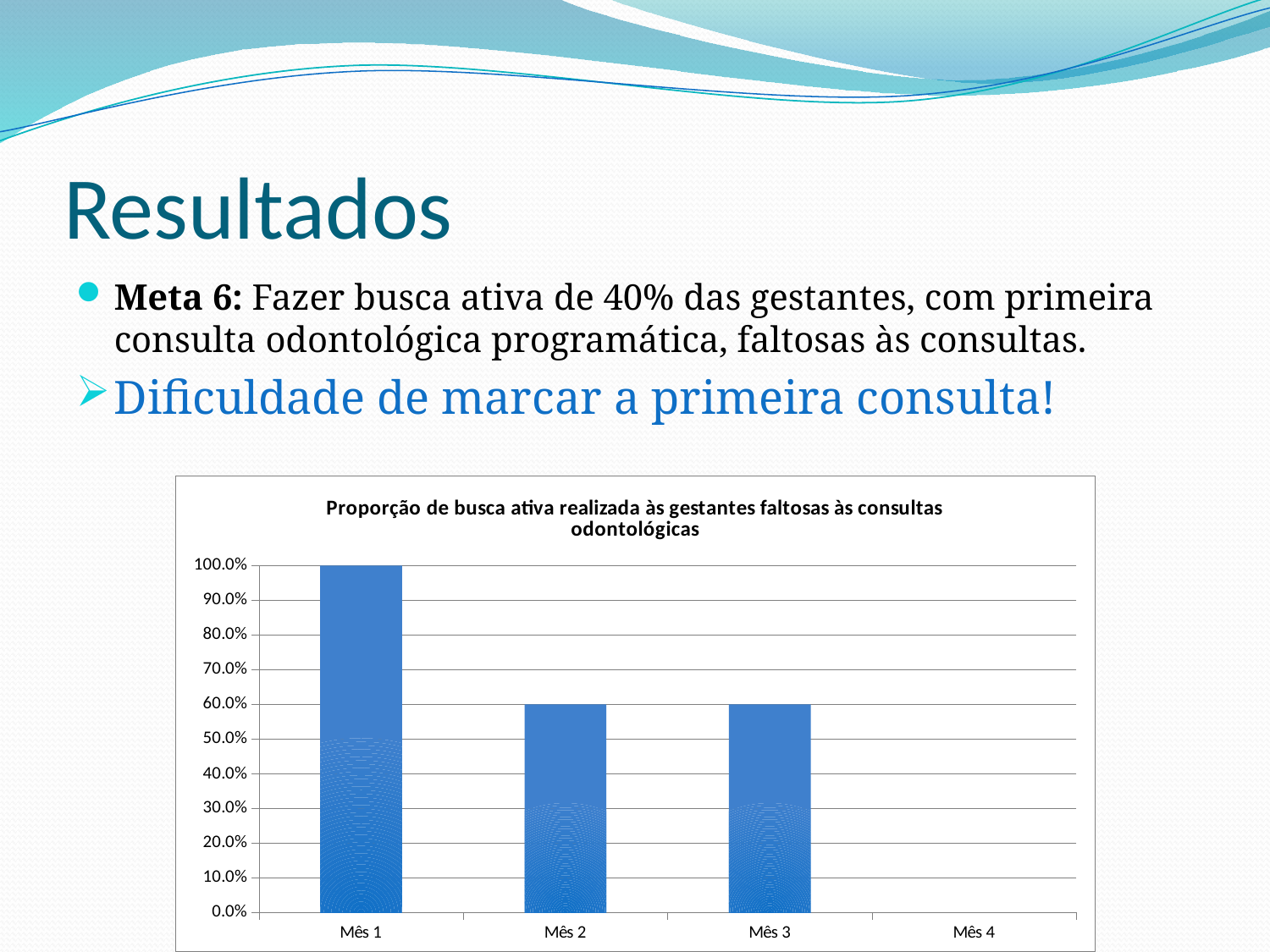
What is the value for Mês 1 in the chart? 100.0% Which is larger, the value for Mês 1 or the value for Mês 2? Mês 1 What kind of chart is shown on the slide? bar chart Is the value for Mês 2 greater or less than 50.0%? greater How many categories are shown on the x axis of the chart? 4 What is the value for Mês 3 in the chart? 60.0% What is the value for Mês 2 in the chart? 60.0% What is the title of the chart? Proporção de busca ativa realizada às gestantes faltosas às consultas odontológicas Does the value rise or fall from Mês 1 to Mês 2? fall Which month has the highest value in the chart? Mês 1 What is the difference between the value for Mês 1 and the value for Mês 2? 40.0% Is the value for Mês 3 greater or less than 70.0%? less